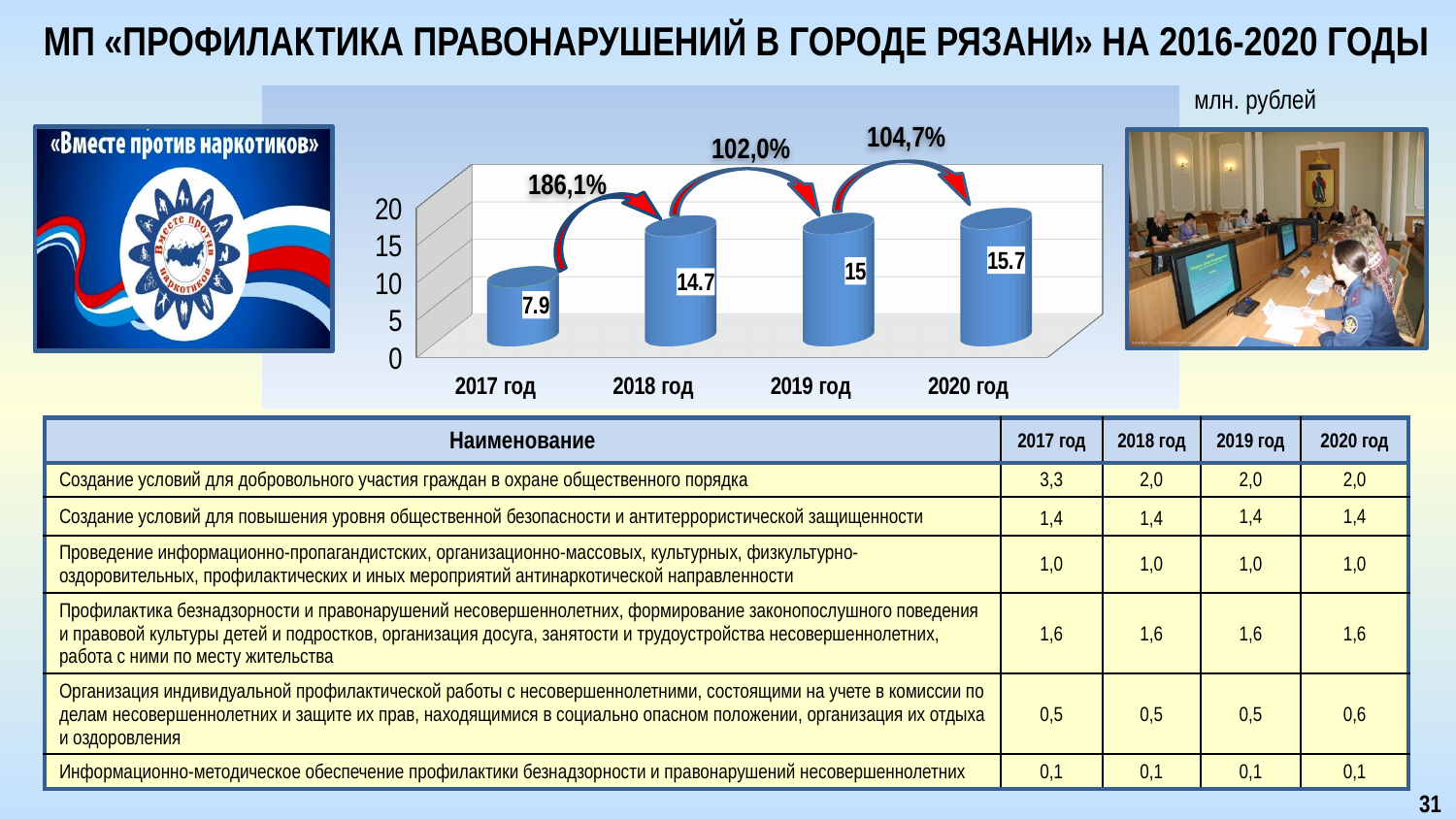
Is the value for 2017 год greater or less than 10? less Which is larger, the value for 2019 год or the value for 2018 год? 2019 год What kind of chart is shown on the slide? bar chart What percentage label is shown on the arrow between 2017 год and 2018 год? 186,1% Which year has the lowest value in the chart? 2017 год What is the value for 2020 год in the chart? 15.7 What is the difference between the values for 2018 год and 2017 год? 6.8 What is the value for 2018 год in the chart? 14.7 How many years are shown on the x axis of the chart? 4 What is the value for 2017 год in the chart? 7.9 Do the values rise or fall from 2017 год to 2020 год? rise Which year has the highest value in the chart? 2020 год